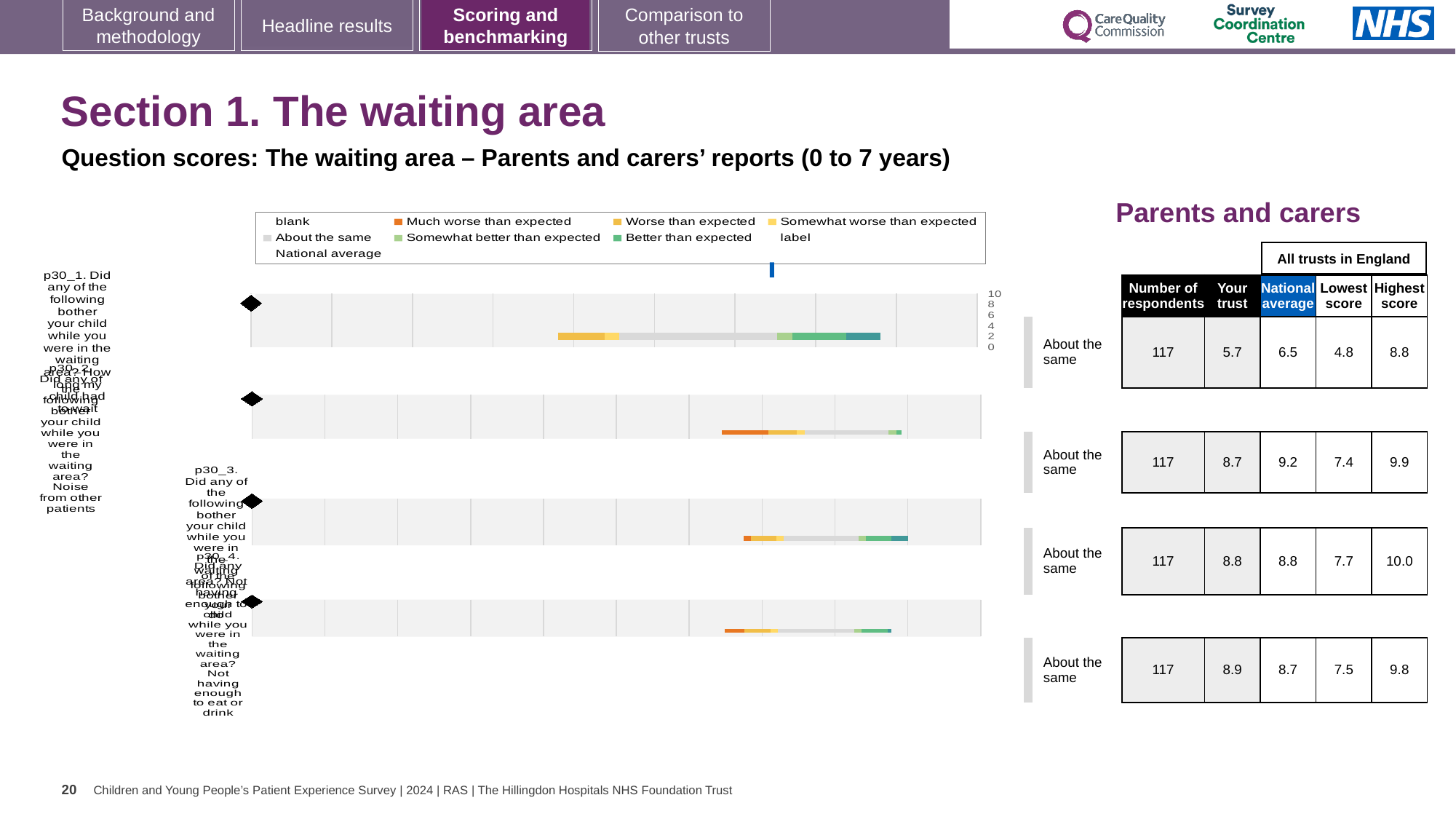
How many respondents are recorded for each question in the table? 117 Is the 'Your trust' score for the first question (p30_1) greater or less than 6? less What benchmark category is shown next to each of the four question bars? About the same What is the highest score across all trusts in England for the third question (p30_3, not having enough to do)? 10.0 How many question bars are plotted in the chart? 4 What is the national average score for the second question (p30_2, noise from other patients)? 9.2 Which question has the highest 'Your trust' score? p30_4 (not having enough to eat or drink) Which question has the lowest 'Your trust' score? p30_1 (how long my child had to wait) What is the 'Your trust' score for the first question (p30_1, how long my child had to wait)? 5.7 For the fourth question (p30_4), which is larger: the 'Your trust' score or the national average? Your trust What kind of chart is shown on the slide? bar chart What is the difference between the national average and the 'Your trust' score for the first question (p30_1)? 0.8